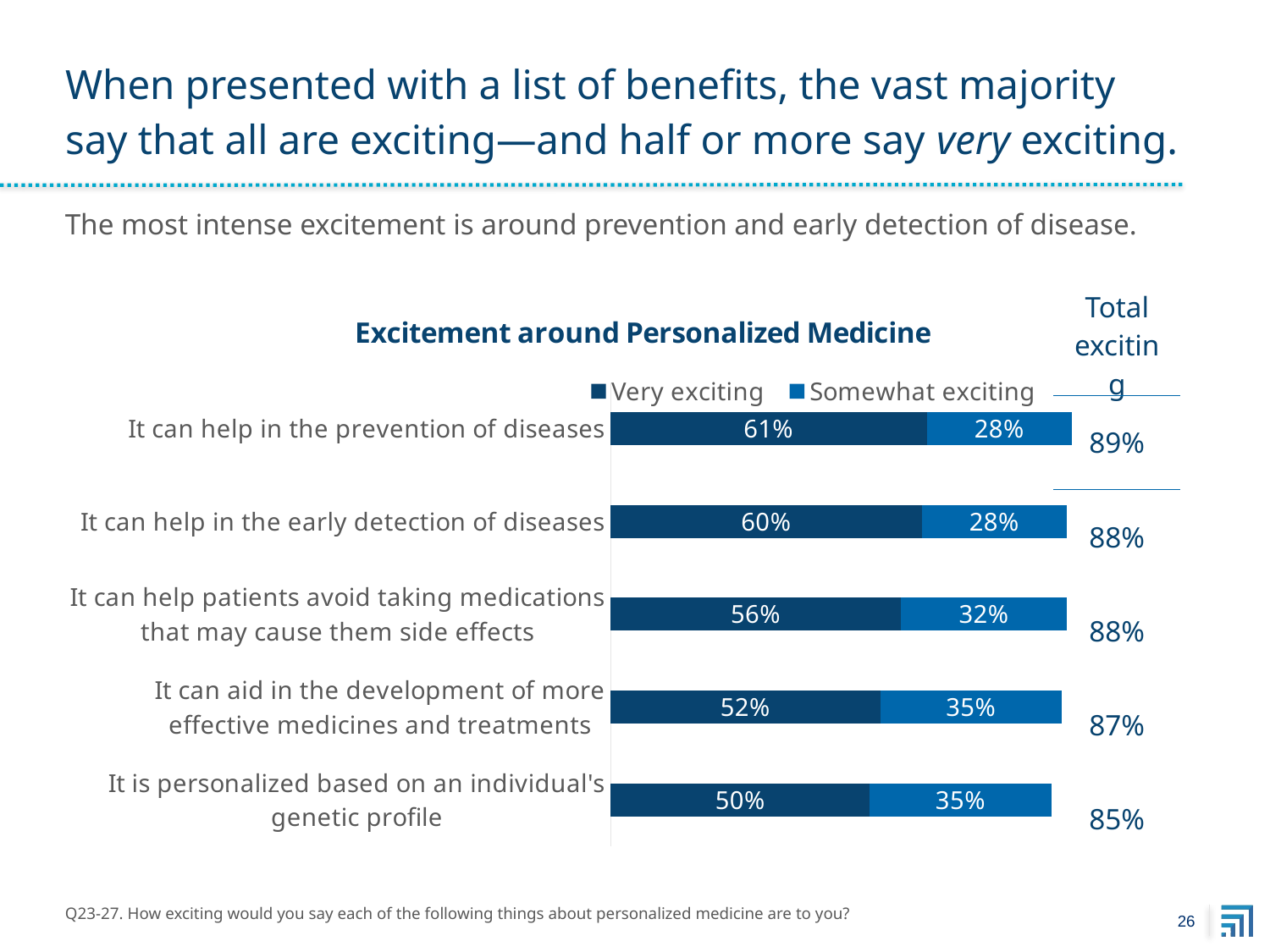
Which benefit has the highest 'Very exciting' percentage? It can help in the prevention of diseases What kind of chart is shown? Stacked bar chart What is the title of the chart? Excitement around Personalized Medicine Which benefit has the lowest 'Very exciting' percentage? It is personalized based on an individual's genetic profile What percentage say 'It is personalized based on an individual's genetic profile' is somewhat exciting? 35% What percentage say 'It can help in the prevention of diseases' is very exciting? 61% Which is larger: the 'Somewhat exciting' share for avoiding medications with side effects, or for early detection of diseases? Avoiding medications with side effects What is the total exciting percentage for 'It can aid in the development of more effective medicines and treatments'? 87% What is the difference between the 'Very exciting' percentages for prevention of diseases and for the genetic profile item? 11% Which series is shown in the darker blue colour? Very exciting How many series does the legend list? 2 How many benefits are listed in the chart? 5